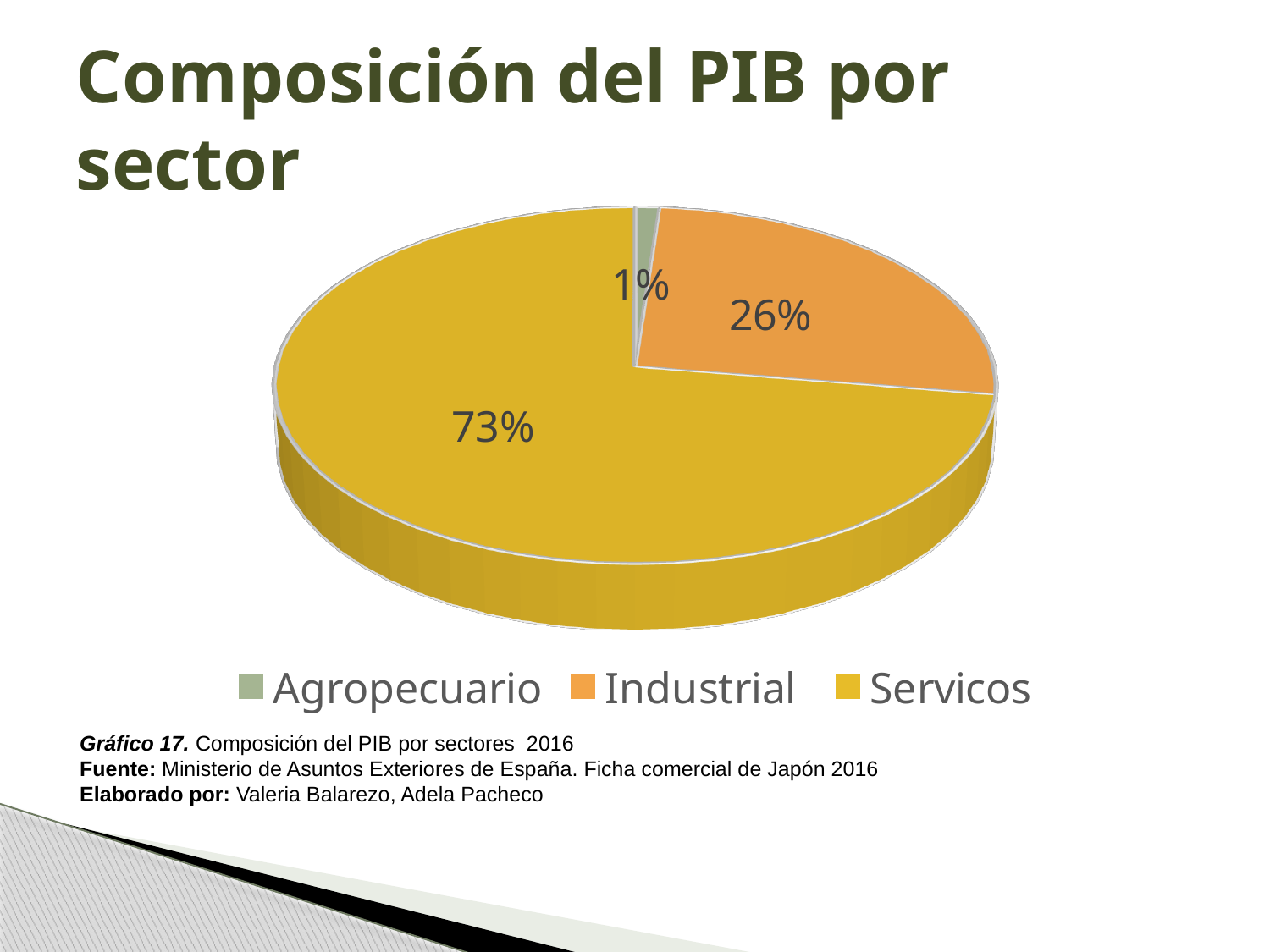
Which is larger, the share for Industrial or the share for Agropecuario? Industrial Which sector has the smallest share of the pie? Agropecuario What share of the pie does Servicos represent? 73% What is the difference in percentage points between the Servicos and Industrial shares? 47 What share of the pie does Agropecuario represent? 1% What kind of chart is shown on the slide? pie chart What share of the pie does Industrial represent? 26% How many sectors are shown in the pie chart? 3 Which sector is shown in orange in the legend? Industrial Which sector has the largest share of the pie? Servicos What is the difference in percentage points between the Industrial and Agropecuario shares? 25 What is the title of the slide containing the pie chart? Composición del PIB por sector